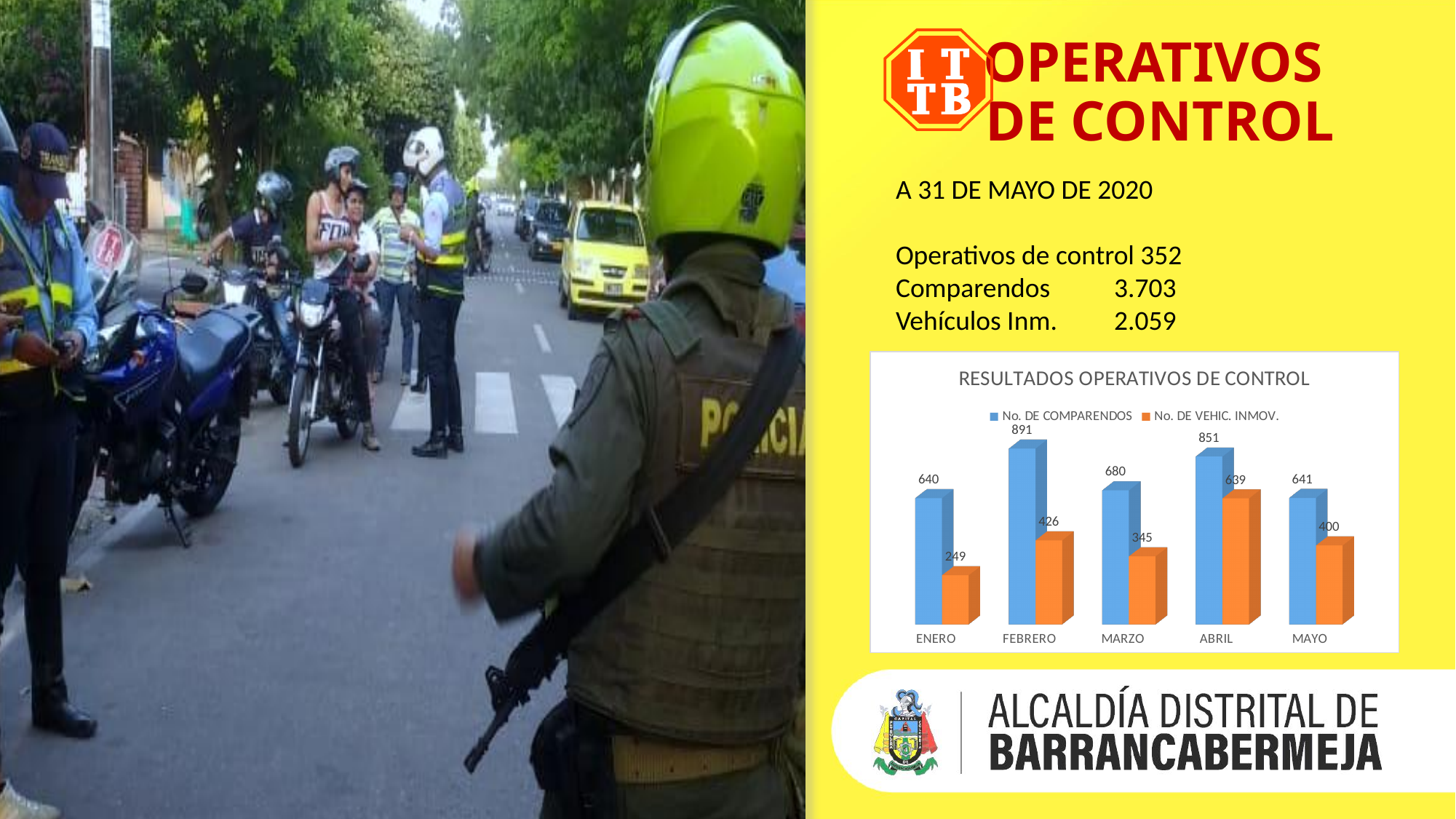
What is the value of No. DE VEHIC. INMOV. for ENERO? 249 Which month has the lowest No. DE VEHIC. INMOV.? ENERO Which is larger, No. DE VEHIC. INMOV. in FEBRERO or in MAYO? FEBRERO Which colour represents No. DE VEHIC. INMOV. in the chart? orange What is the value of No. DE COMPARENDOS for FEBRERO? 891 How many series does the legend list? 2 What is the value of No. DE COMPARENDOS for MARZO? 680 How many months are shown on the x axis? 5 What type of chart is shown? bar chart What is the difference between No. DE COMPARENDOS and No. DE VEHIC. INMOV. in ABRIL? 212 What is the title of the chart? RESULTADOS OPERATIVOS DE CONTROL Which month has the highest No. DE COMPARENDOS? FEBRERO